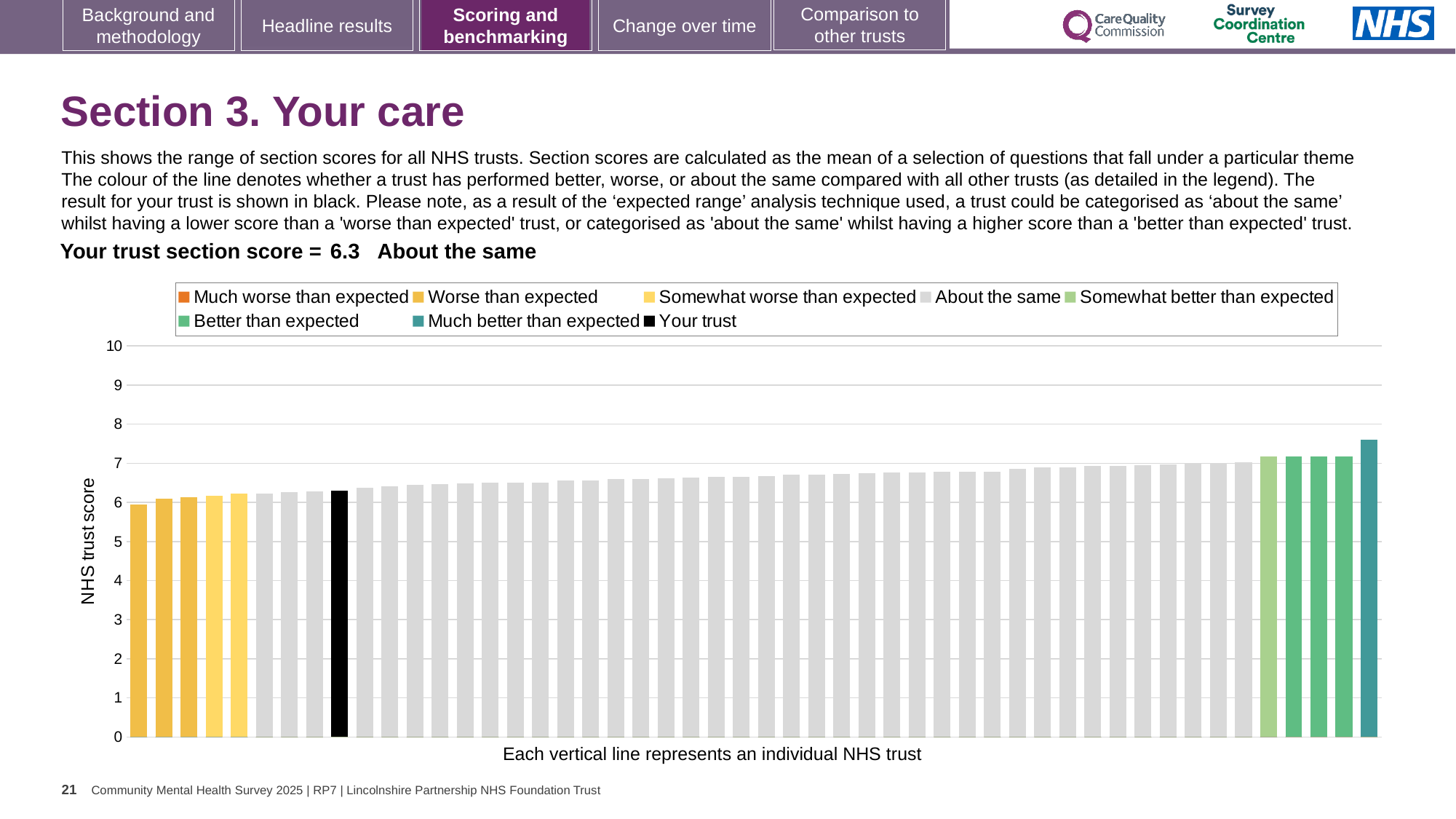
What is the section score for your trust shown on the slide? 6.3 Is the value of the shortest bar greater or less than 5? greater How is your trust's section score categorised on the slide? About the same What colour is used for the 'Your trust' bar in the chart? black Do the bar values rise or fall from left to right along the x axis? rise What kind of chart is shown on the slide? bar chart Which legend category does the tallest bar belong to? Much better than expected Is the value of the tallest bar greater or less than 7? greater Is the value of the black 'Your trust' bar greater or less than 5? greater Which is larger: the value of the black 'Your trust' bar or the value of the leftmost bar? Your trust What is the label on the y axis of the chart? NHS trust score How many entries does the chart legend list? 8